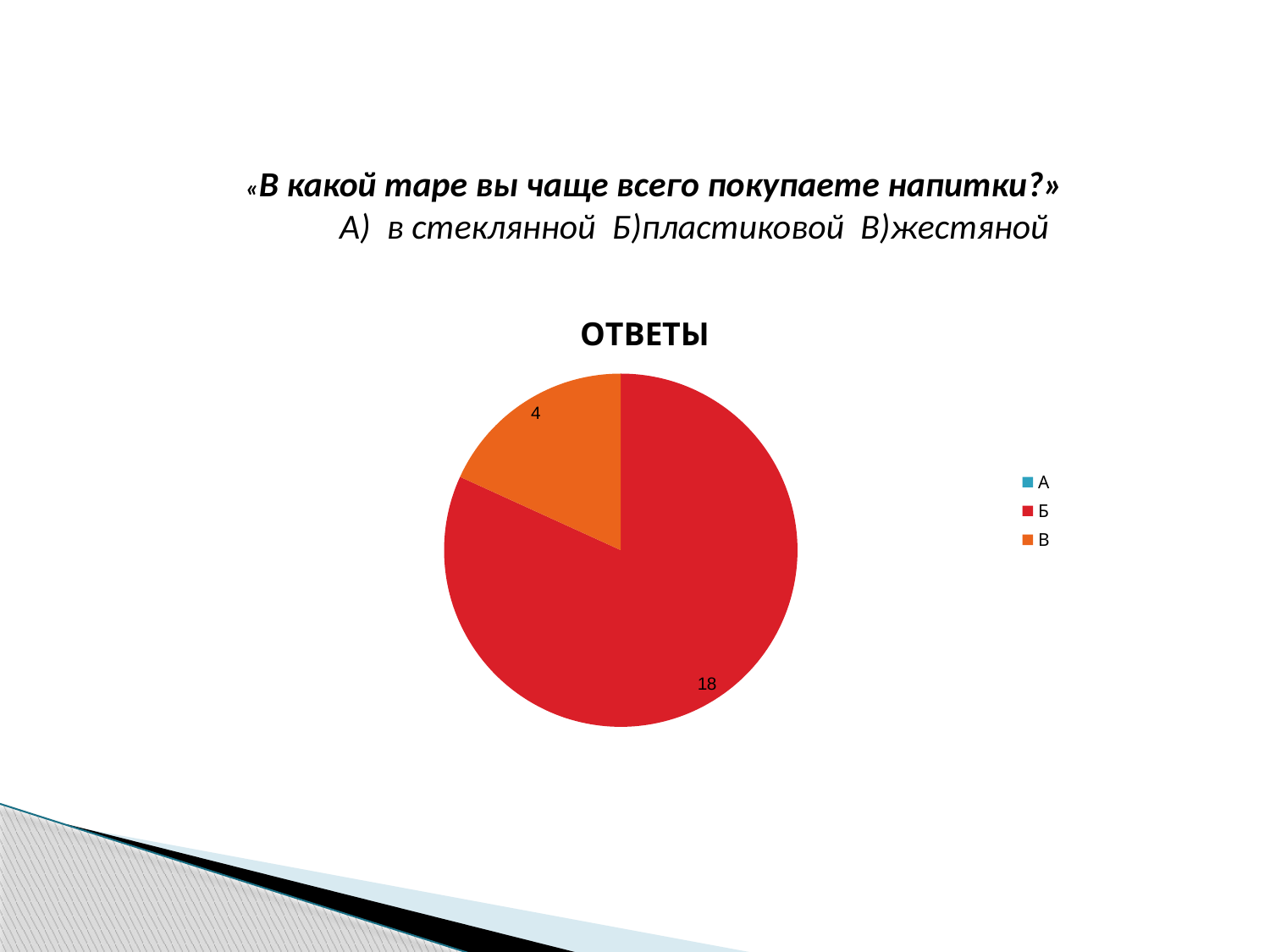
What is the title of the chart? ОТВЕТЫ How many entries does the legend of the chart list? 3 Which category has the largest slice in the pie chart? Б Which of the two labelled slices, Б or В, is larger? Б What colour is the slice for category Б? Red What is the value of slice Б in the pie chart? 18 What kind of chart is shown on the slide? Pie chart What is the value of slice В in the pie chart? 4 How many slices with data labels are visible in the pie chart? 2 What is the difference between the values of slices Б and В? 14